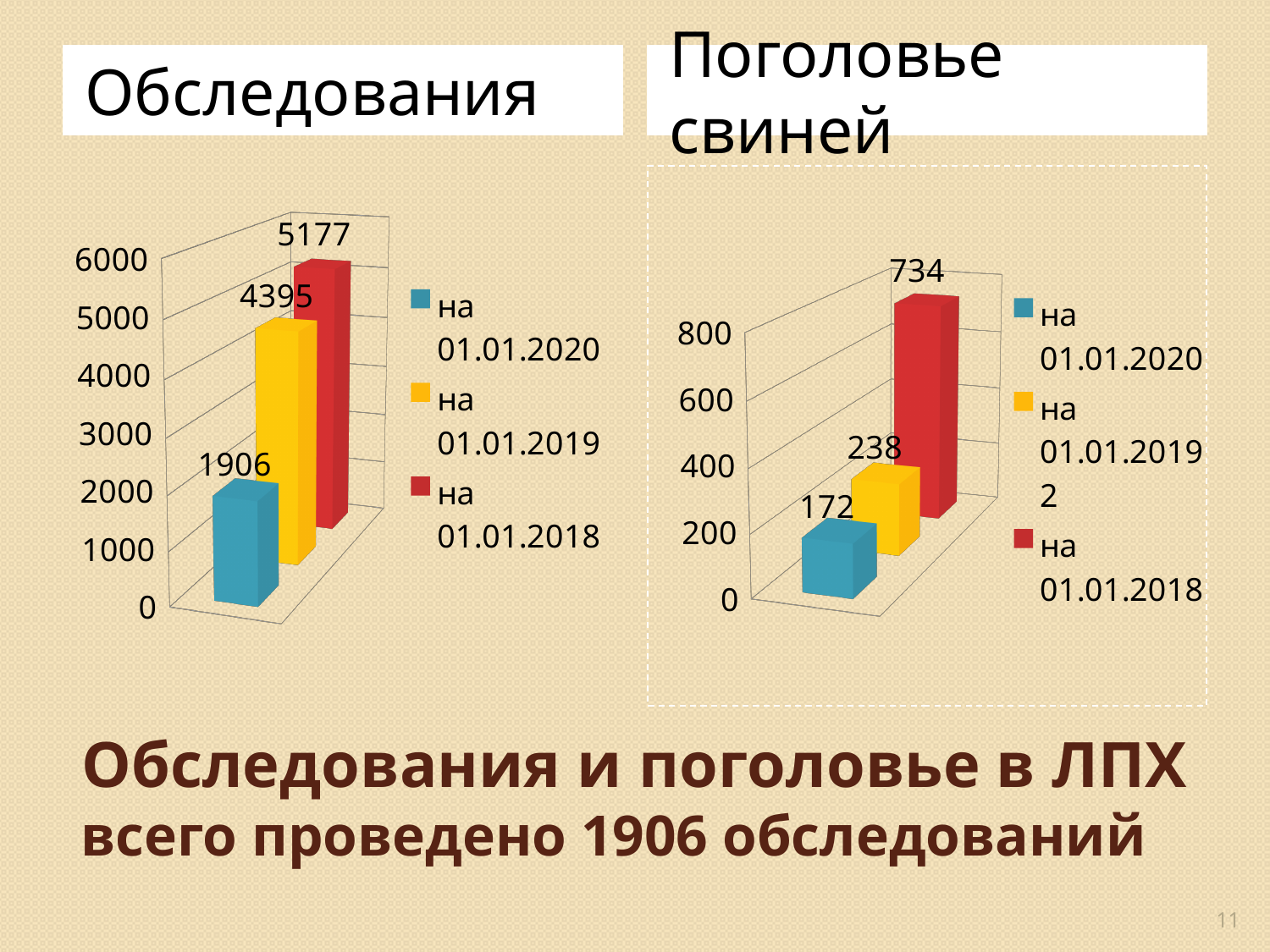
In the "Поголовье свиней" chart, which series has the lowest value? на 01.01.2020 In the "Обследования" chart, what is the value for "на 01.01.2020"? 1906 In the "Поголовье свиней" chart, what is the difference between the values for "на 01.01.2018" and "на 01.01.2020"? 562 In the "Поголовье свиней" chart, what is the value for "на 01.01.2019"? 238 What kind of chart is the "Обследования" chart? bar chart In the "Обследования" chart, what is the value for "на 01.01.2018"? 5177 In the "Поголовье свиней" chart, which is larger: the value for "на 01.01.2020" or "на 01.01.2019"? на 01.01.2019 In the "Обследования" chart, what colour is the bar for "на 01.01.2019"? yellow In the "Обследования" chart, which series has the highest value? на 01.01.2018 In the "Обследования" chart, how many series does the legend list? 3 In the "Поголовье свиней" chart, what is the value for "на 01.01.2018"? 734 In the "Обследования" chart, what is the difference between the values for "на 01.01.2018" and "на 01.01.2019"? 782